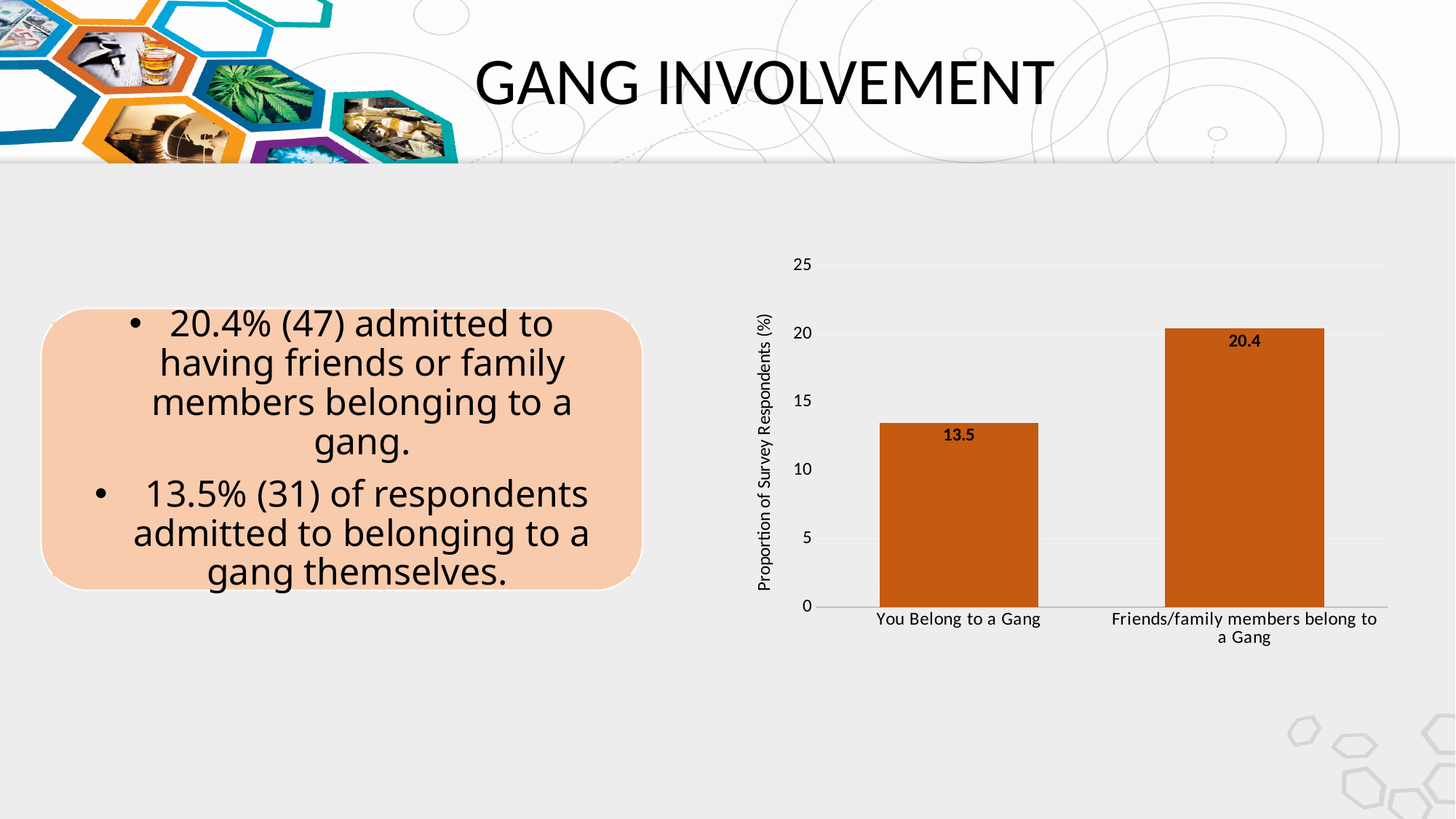
What is the value for "Friends/family members belong to a Gang"? 20.4 How many categories are shown in the chart? 2 Which category has the lowest value? You Belong to a Gang What is the value for "You Belong to a Gang"? 13.5 What is the highest value shown on the vertical axis? 25 What is the difference between the values for "Friends/family members belong to a Gang" and "You Belong to a Gang"? 6.9 What is the label of the vertical axis? Proportion of Survey Respondents (%) Is the value for "Friends/family members belong to a Gang" greater or less than 20? greater Is the value for "You Belong to a Gang" greater or less than 15? less Which category has the highest value? Friends/family members belong to a Gang Which is larger: the value for "You Belong to a Gang" or for "Friends/family members belong to a Gang"? Friends/family members belong to a Gang What kind of chart is shown on the slide? bar chart